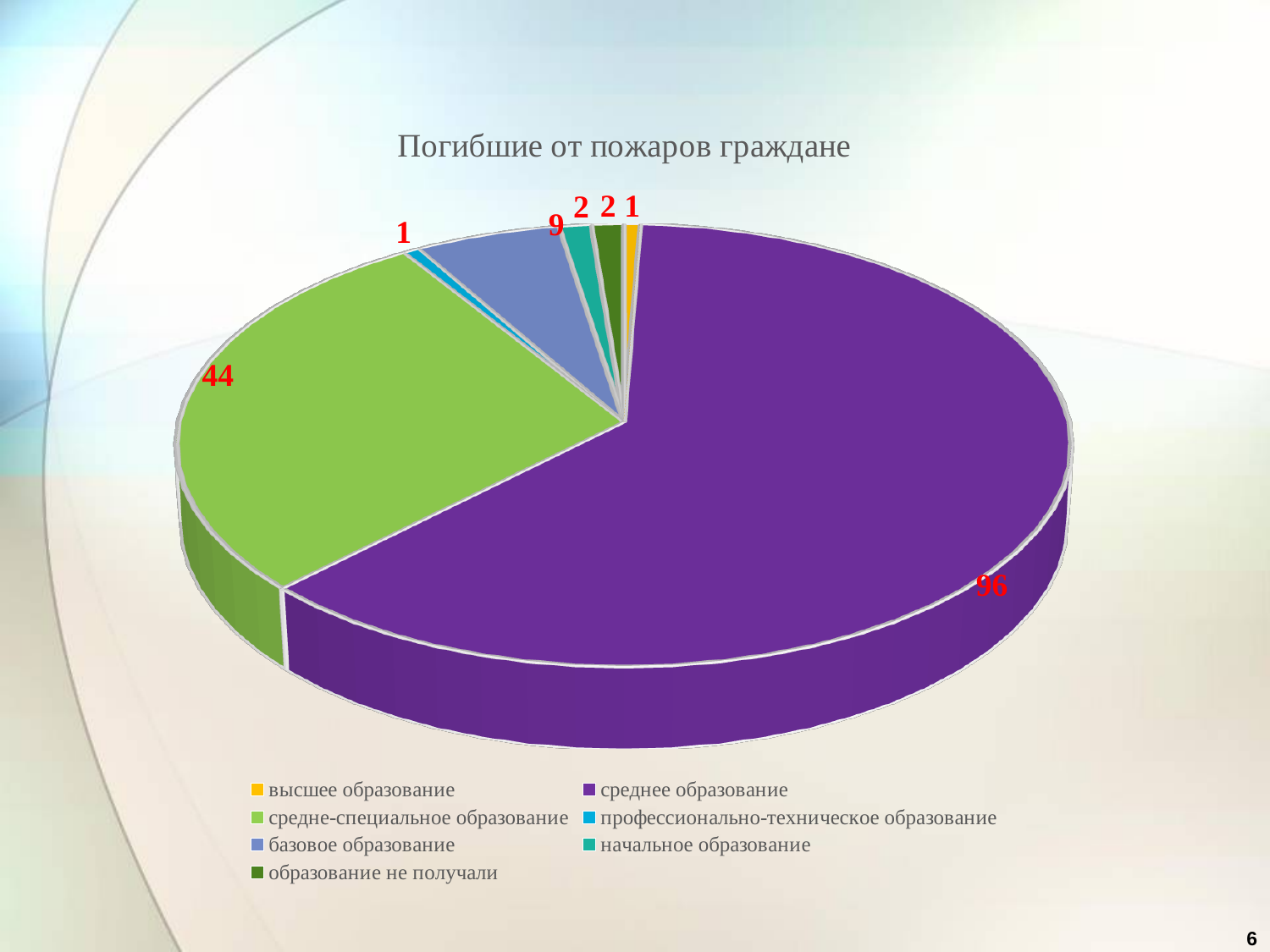
Which is larger, the value for базовое образование or the value for начальное образование? базовое образование What value is shown for the средне-специальное образование slice? 44 Which category has the largest slice of the pie? среднее образование What kind of chart is shown on the slide? pie chart What is the title of the chart? Погибшие от пожаров граждане How many categories does the pie chart show? 7 What is the total of all the values shown on the pie chart? 155 What value is shown for the высшее образование slice? 1 What value is shown for the начальное образование slice? 2 What value is shown for the базовое образование slice? 9 What value is shown for the среднее образование slice? 96 What is the difference between the values for среднее образование and средне-специальное образование? 52